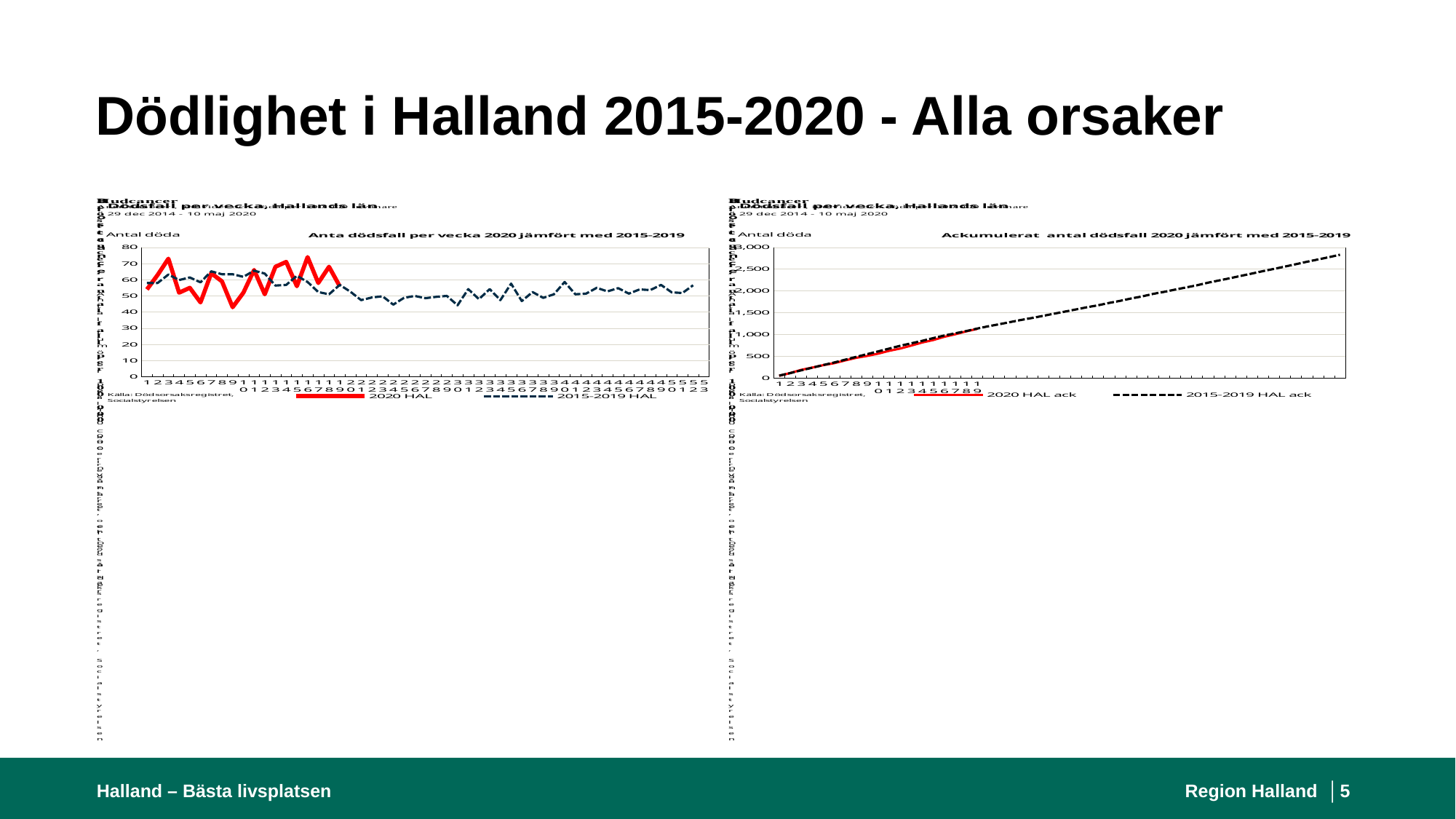
What kind of chart is the left chart titled 'Anta dödsfall per vecka 2020 jämfört med 2015-2019'? Line chart In the left chart 'Anta dödsfall per vecka 2020 jämfört med 2015-2019', what are the two legend entries? 2020 HAL and 2015-2019 HAL In the right chart 'Ackumulerat antal dödsfall 2020 jämfört med 2015-2019', is the final value of 2015-2019 HAL ack greater or less than 2,500? greater In the right chart 'Ackumulerat antal dödsfall 2020 jämfört med 2015-2019', does the 2015-2019 HAL ack line rise or fall along the x axis? Rise In the right chart 'Ackumulerat antal dödsfall 2020 jämfört med 2015-2019', how many series does the legend list? 2 In the left chart 'Anta dödsfall per vecka 2020 jämfört med 2015-2019', is the value for 2015-2019 HAL at week 30 greater or less than 60? less In the left chart 'Anta dödsfall per vecka 2020 jämfört med 2015-2019', how many series does the legend list? 2 In the right chart 'Ackumulerat antal dödsfall 2020 jämfört med 2015-2019', what colour is the line for 2020 HAL ack? Red What kind of chart is the right chart titled 'Ackumulerat antal dödsfall 2020 jämfört med 2015-2019'? Line chart In the left chart 'Anta dödsfall per vecka 2020 jämfört med 2015-2019', is the value for 2020 HAL at week 9 greater or less than 50? less In the left chart 'Anta dödsfall per vecka 2020 jämfört med 2015-2019', what is the label of the y axis? Antal döda